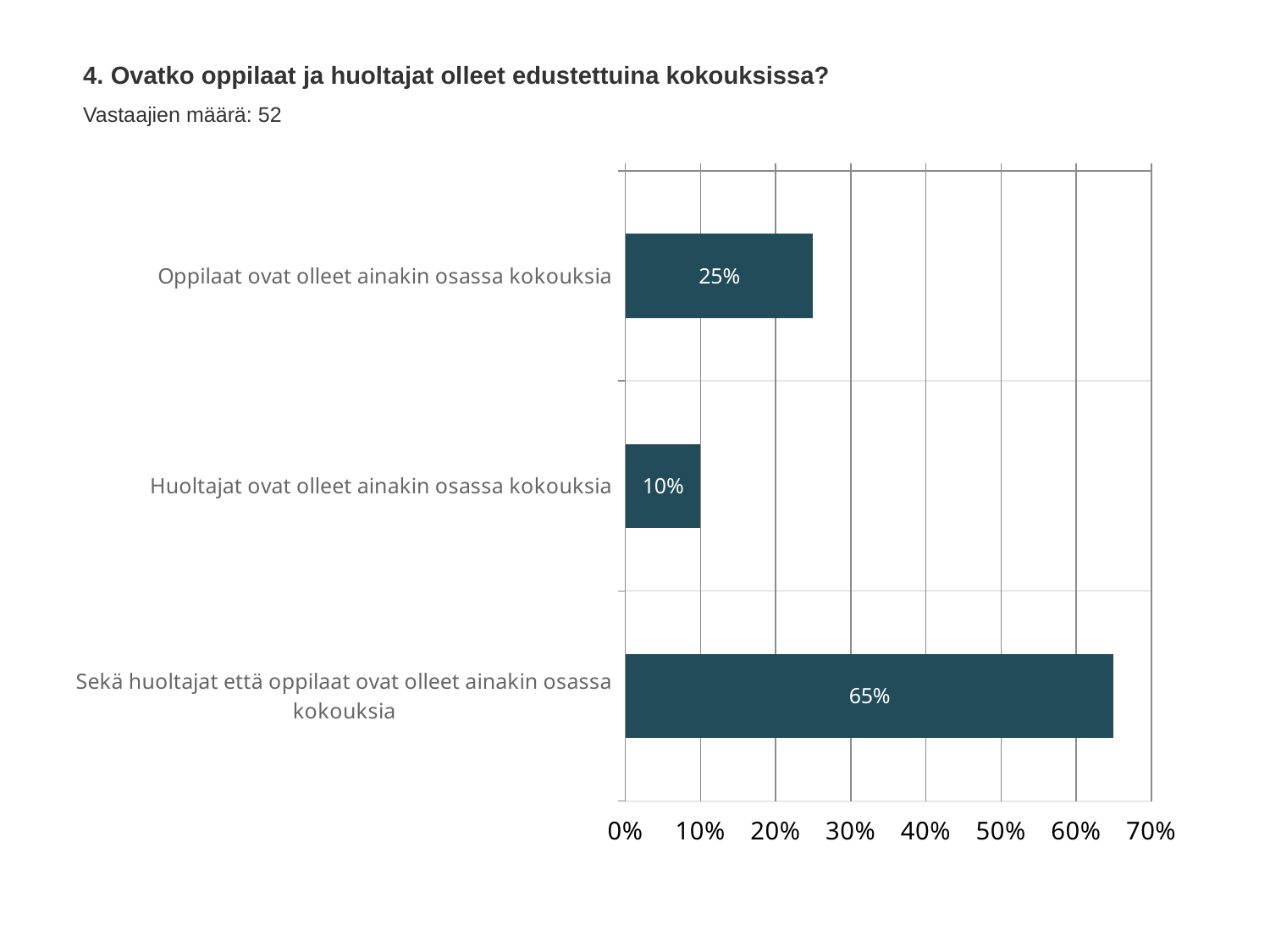
Which category has the lowest value? Huoltajat ovat olleet ainakin osassa kokouksia How many categories are shown in the chart? 3 What is the difference between the values for "Sekä huoltajat että oppilaat ovat olleet ainakin osassa kokouksia" and "Oppilaat ovat olleet ainakin osassa kokouksia"? 40% What kind of chart is shown on the slide? Bar chart Which is larger: the value for "Oppilaat ovat olleet ainakin osassa kokouksia" or "Huoltajat ovat olleet ainakin osassa kokouksia"? Oppilaat ovat olleet ainakin osassa kokouksia What is the value for "Huoltajat ovat olleet ainakin osassa kokouksia"? 10% Is the value for "Sekä huoltajat että oppilaat ovat olleet ainakin osassa kokouksia" greater or less than 50%? greater What is the difference between the values for "Oppilaat ovat olleet ainakin osassa kokouksia" and "Huoltajat ovat olleet ainakin osassa kokouksia"? 15% How many respondents (Vastaajien määrä) are reported on the slide? 52 What is the value for "Oppilaat ovat olleet ainakin osassa kokouksia"? 25% What is the value for "Sekä huoltajat että oppilaat ovat olleet ainakin osassa kokouksia"? 65% Which category has the highest value? Sekä huoltajat että oppilaat ovat olleet ainakin osassa kokouksia